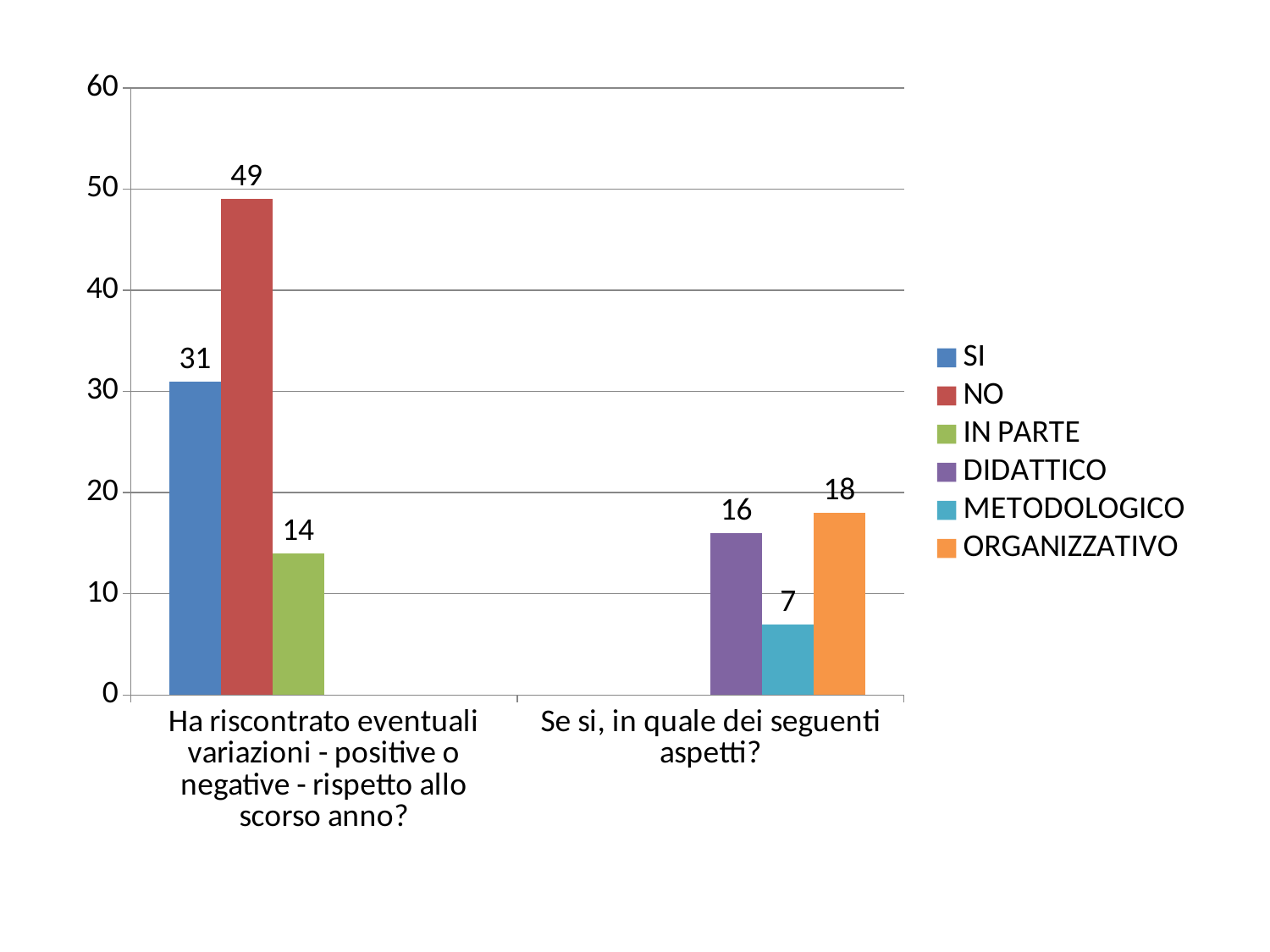
What is the value for NO in the first category ("Ha riscontrato eventuali variazioni...")? 49 Which series has the highest value in the chart? NO How many series does the legend list? 6 What is the value for IN PARTE? 14 What is the difference between the values for NO and SI? 18 What is the value for METODOLOGICO? 7 What is the value for SI? 31 What is the value for ORGANIZZATIVO? 18 Which series has the lowest value in the chart? METODOLOGICO Which is larger, DIDATTICO or ORGANIZZATIVO? ORGANIZZATIVO What kind of chart is shown on the slide? Bar chart What colour is the bar for DIDATTICO? Purple